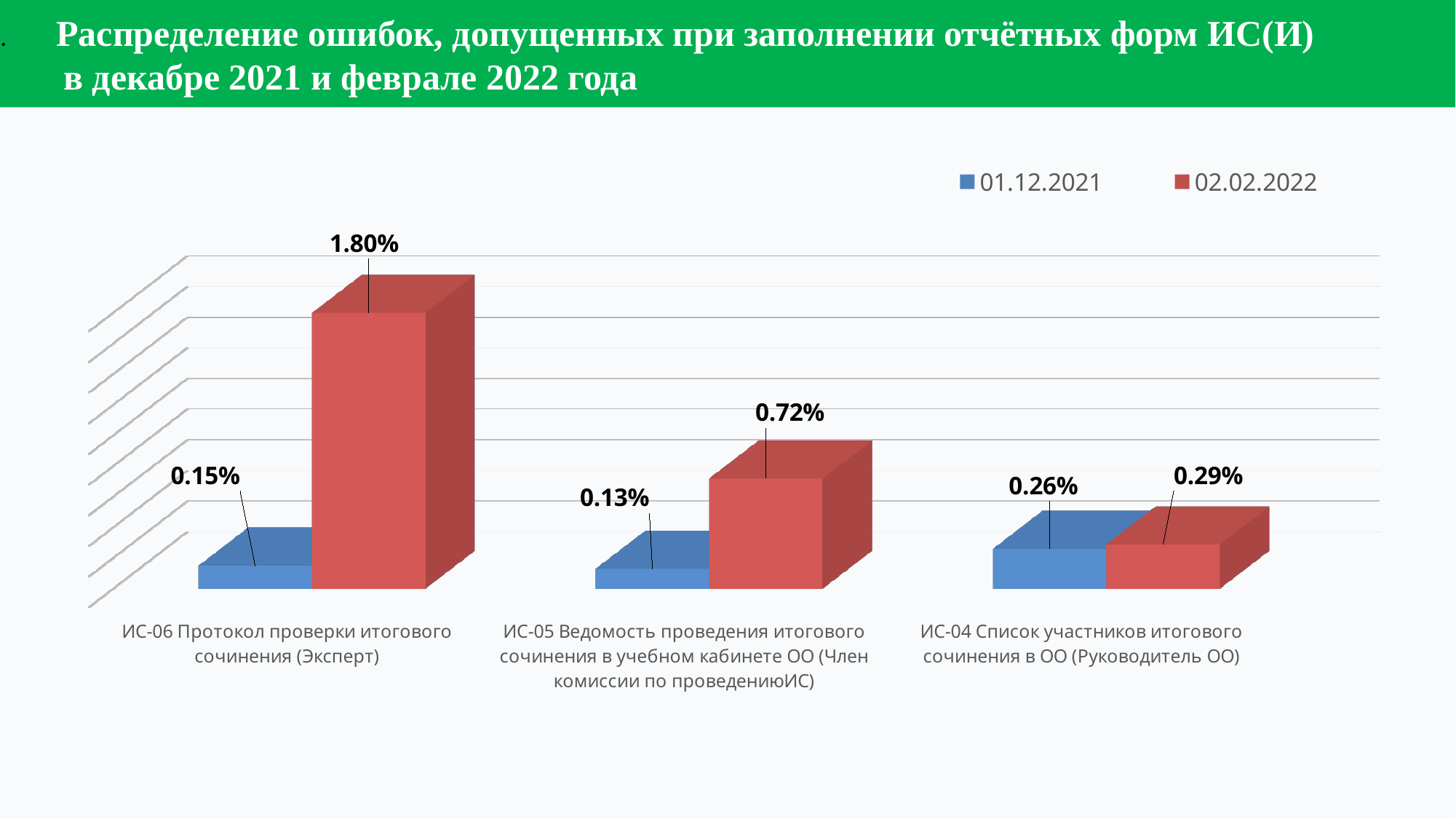
What type of chart is shown on the slide? bar chart What is the difference between the 02.02.2022 and 01.12.2021 values for ИС-06 Протокол проверки итогового сочинения (Эксперт)? 1.65% Which is larger for ИС-05: the 01.12.2021 value or the 02.02.2022 value? 02.02.2022 How many series does the legend list? 2 Which colour represents the 01.12.2021 series in the legend? blue Which category has the lowest value for the 01.12.2021 series? ИС-05 Ведомость проведения итогового сочинения в учебном кабинете ОО (Член комиссии по проведениюИС) What is the value for 01.12.2021 for ИС-04 Список участников итогового сочинения в ОО (Руководитель ОО)? 0.26% What is the value for 02.02.2022 for ИС-04 Список участников итогового сочинения в ОО (Руководитель ОО)? 0.29% What is the value for 01.12.2021 for ИС-05 Ведомость проведения итогового сочинения в учебном кабинете ОО? 0.13% How many categories are shown on the x axis? 3 Which category has the highest value for the 02.02.2022 series? ИС-06 Протокол проверки итогового сочинения (Эксперт) What is the value for 02.02.2022 for ИС-06 Протокол проверки итогового сочинения (Эксперт)? 1.80%